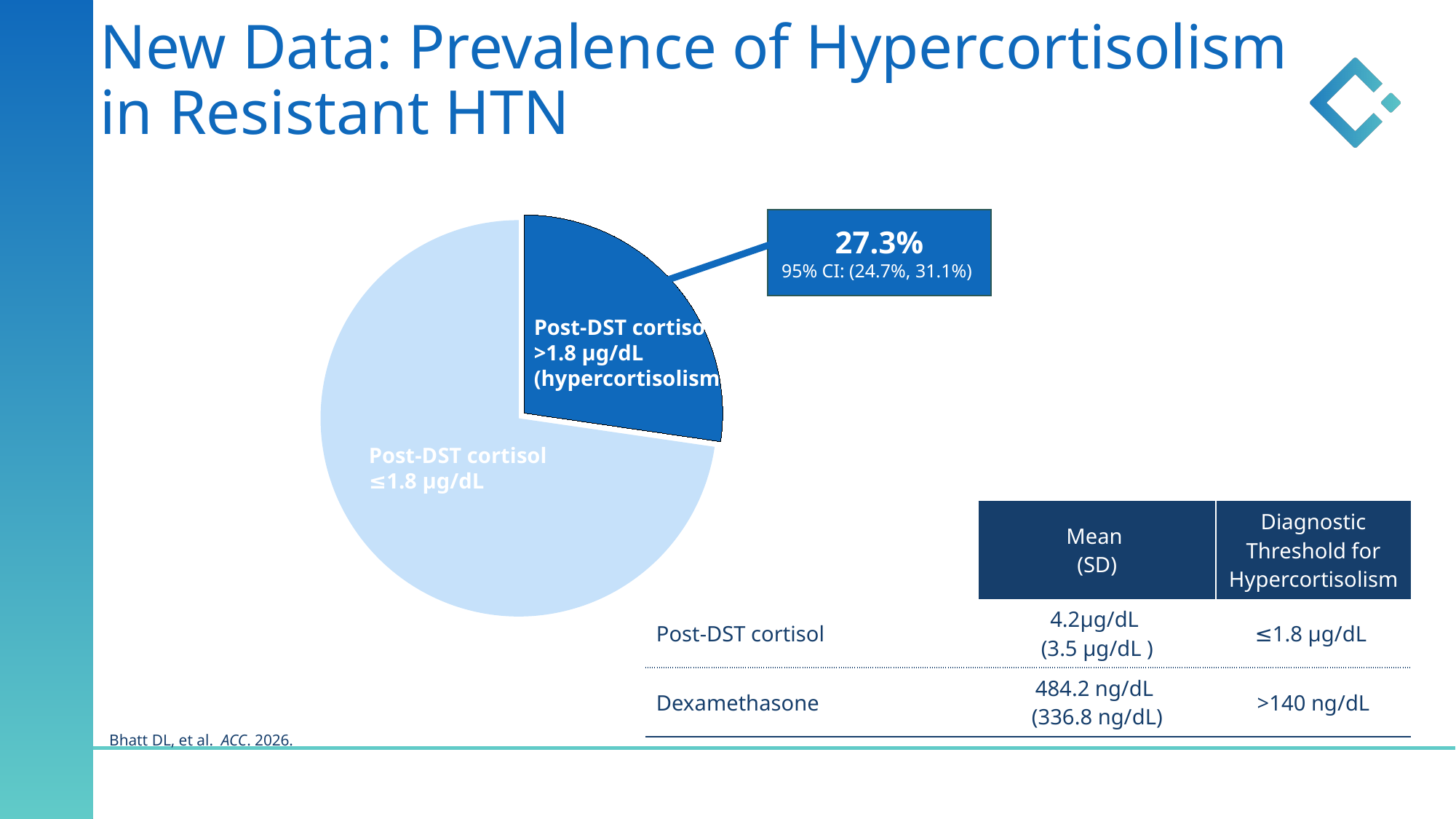
What colour is the slice representing hypercortisolism (Post-DST cortisol >1.8 µg/dL)? Dark blue How many slices does the pie chart have? 2 Which slice of the pie is pulled out (exploded) from the rest of the pie? Post-DST cortisol >1.8 µg/dL (hypercortisolism) What kind of chart is shown on the slide? Pie chart What is the 95% confidence interval shown for the hypercortisolism slice? (24.7%, 31.1%) Which slice of the pie is larger: Post-DST cortisol ≤1.8 µg/dL or Post-DST cortisol >1.8 µg/dL? Post-DST cortisol ≤1.8 µg/dL Which slice of the pie is the largest? Post-DST cortisol ≤1.8 µg/dL What share of the pie is labelled Post-DST cortisol >1.8 µg/dL (hypercortisolism)? 27.3% Which slice of the pie is the smallest? Post-DST cortisol >1.8 µg/dL (hypercortisolism)